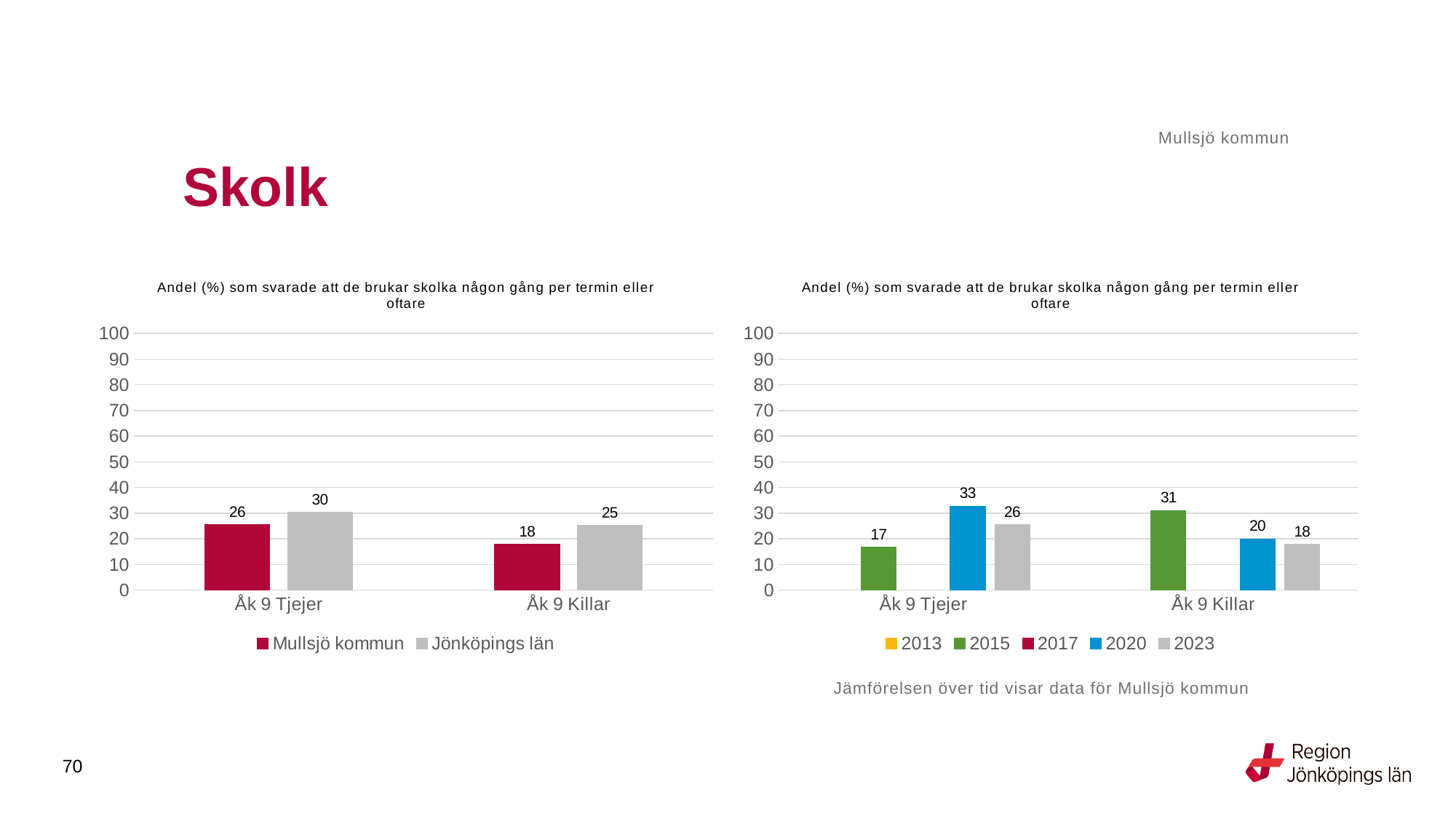
In the left chart, what is the value for Mullsjö kommun for Åk 9 Tjejer? 26 In the right chart, how many series does the legend list? 5 What kind of chart is the left chart? bar chart In the right chart, how many categories are shown on the x axis? 2 In the left chart, which is larger for Åk 9 Tjejer: Mullsjö kommun or Jönköpings län? Jönköpings län In the left chart, what is the value for Jönköpings län for Åk 9 Killar? 25 In the right chart, what is the value for 2015 for Åk 9 Killar? 31 In the left chart, how many series does the legend list? 2 In the right chart, which year has the lowest value for Åk 9 Tjejer? 2015 In the right chart, what is the difference between 2015 and 2023 for Åk 9 Killar? 13 In the right chart, what is the value for 2020 for Åk 9 Tjejer? 33 In the left chart, what is the difference between Jönköpings län and Mullsjö kommun for Åk 9 Killar? 7